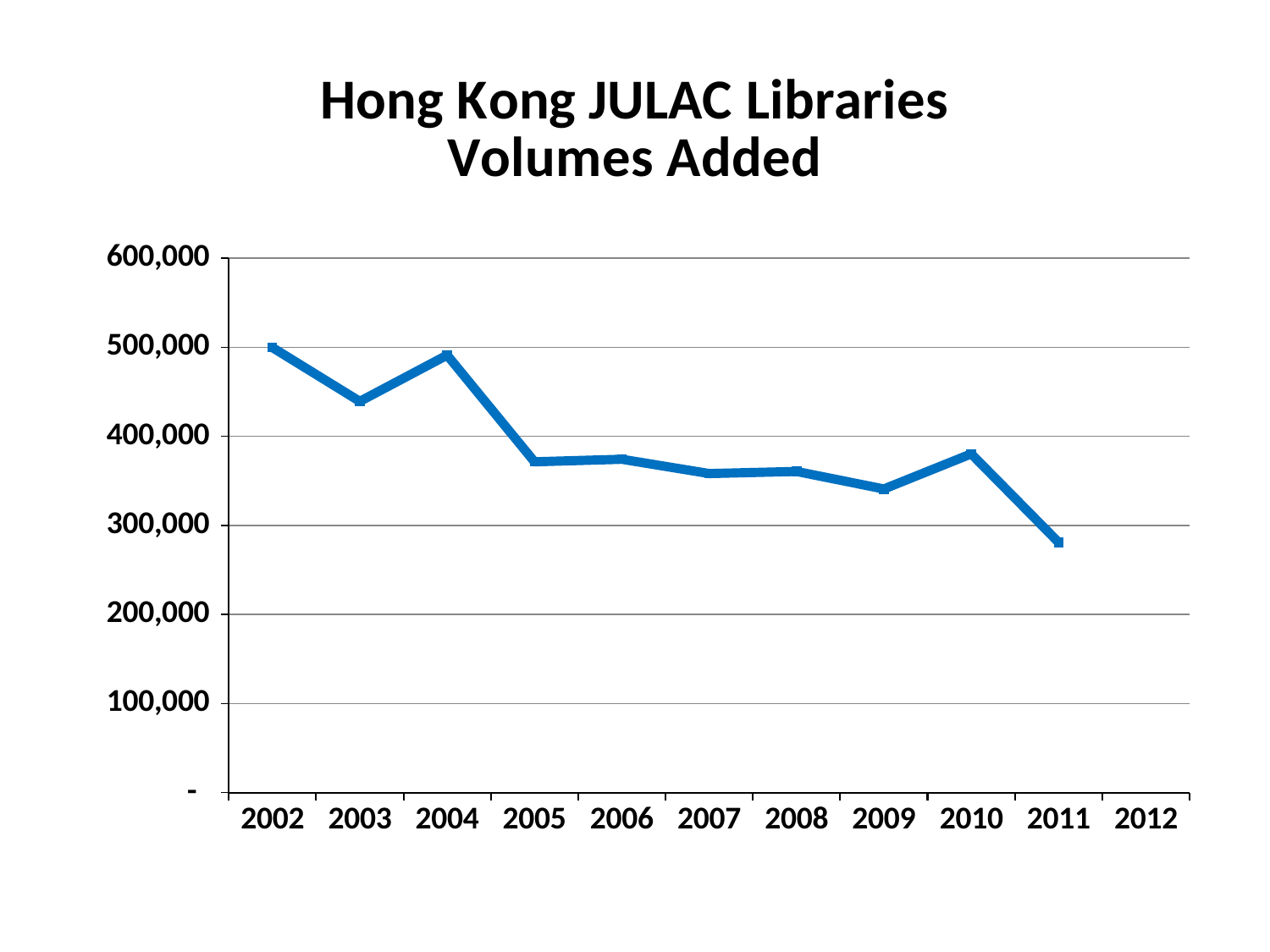
Overall, do the volumes added rise or fall from 2002 to 2011? fall Which year has the larger value, 2009 or 2010? 2010 What is the title of the chart? Hong Kong JULAC Libraries Volumes Added Is the value for 2010 greater or less than 400,000? less What kind of chart is shown on the slide? line chart Is the value for 2009 greater or less than 400,000? less Which year has the larger value, 2004 or 2005? 2004 Is the value for 2011 greater or less than 300,000? less How many years have a plotted data point on the line? 10 Which year has the lowest number of volumes added? 2011